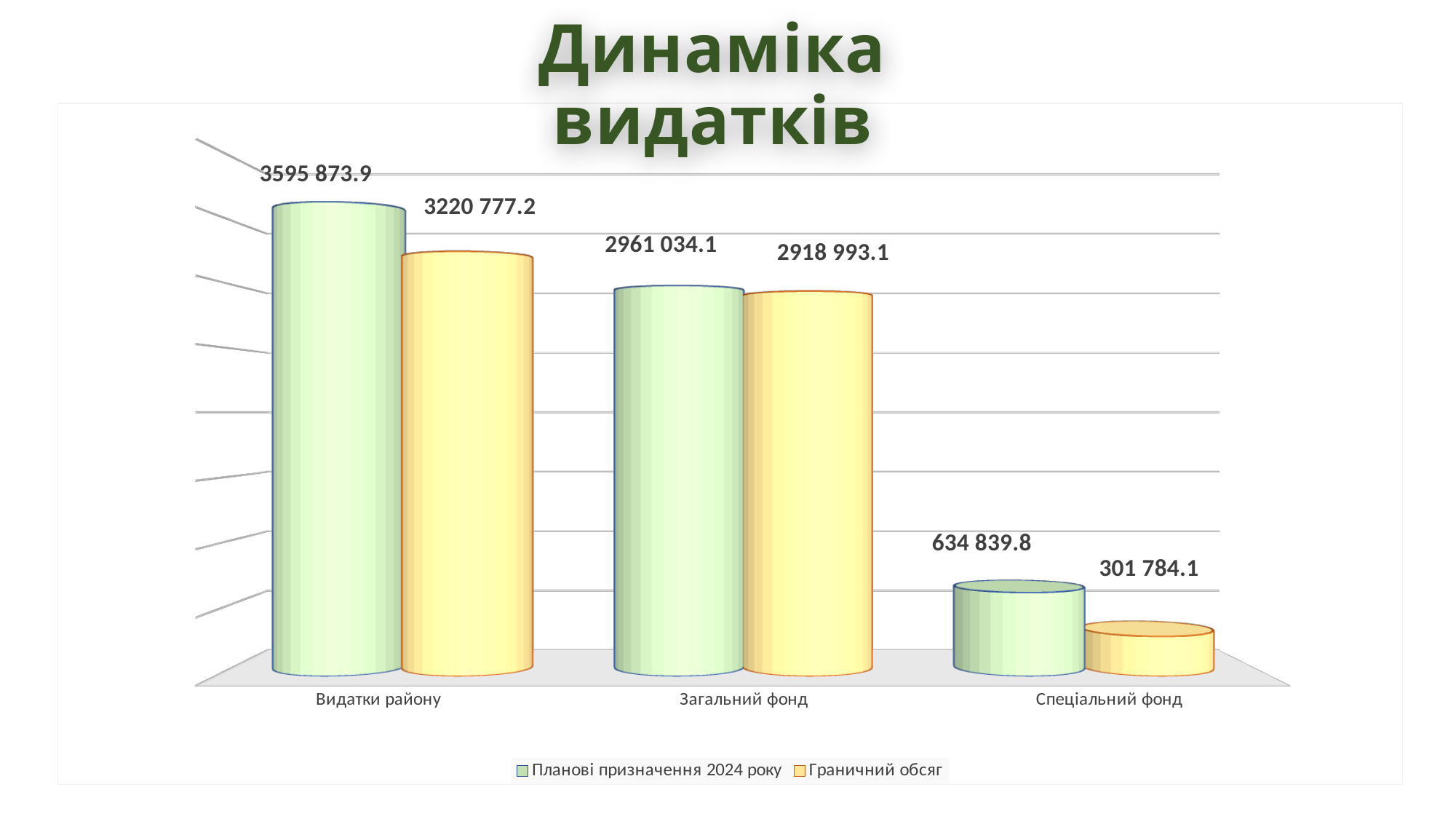
For Загальний фонд, which is larger: Планові призначення 2024 року or Граничний обсяг? Планові призначення 2024 року What is the value of Планові призначення 2024 року for Спеціальний фонд? 634 839.8 How many categories are shown on the x axis? 3 Which category has the highest value for Граничний обсяг? Видатки району What kind of chart is shown on the slide? Bar chart What is the value of Граничний обсяг for Загальний фонд? 2918 993.1 What is the difference between Планові призначення 2024 року and Граничний обсяг for Спеціальний фонд? 333 055.7 What is the value of Планові призначення 2024 року for Видатки району? 3595 873.9 Which category has the lowest value for Планові призначення 2024 року? Спеціальний фонд What is the difference between Планові призначення 2024 року and Граничний обсяг for Видатки району? 375 096.7 What is the value of Граничний обсяг for Спеціальний фонд? 301 784.1 How many series does the legend list? 2